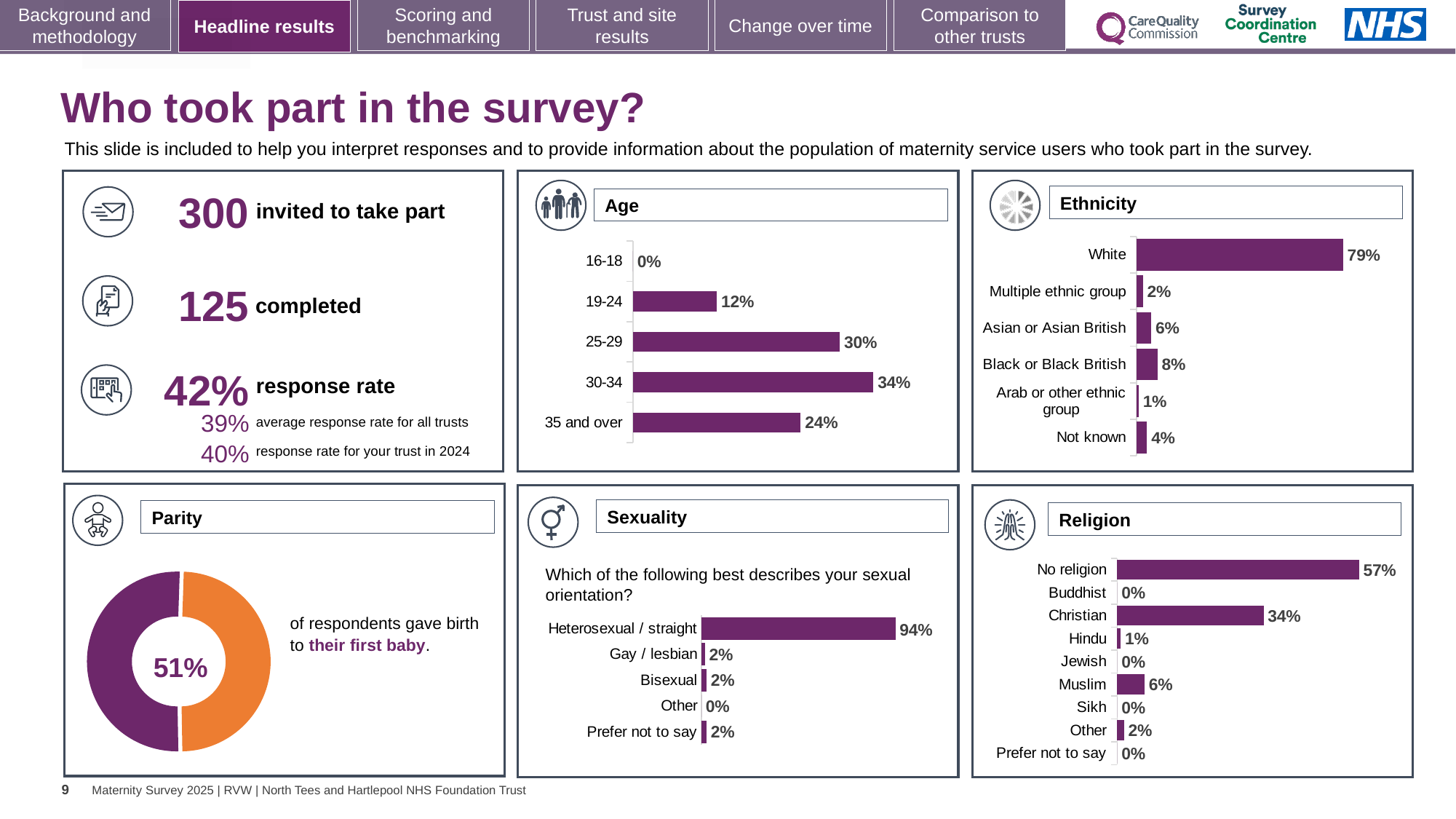
In the Ethnicity chart, which is larger: Black or Black British or Asian or Asian British? Black or Black British In the Parity chart, what share of respondents gave birth to their first baby? 51% In the Age chart, what percentage of respondents were aged 30-34? 34% In the Ethnicity chart, which category has the lowest percentage? Arab or other ethnic group In the Sexuality chart, what percentage of respondents answered Heterosexual / straight? 94% In the Religion chart, what is the difference between No religion and Muslim? 51% How many categories are shown in the Ethnicity chart? 6 In the Ethnicity chart, what percentage of respondents were White? 79% What kind of chart is the Parity chart? Doughnut chart In the Age chart, what is the difference between the 25-29 and 19-24 percentages? 18% In the Age chart, which age group has the highest percentage? 30-34 In the Religion chart, what percentage of respondents were Christian? 34%